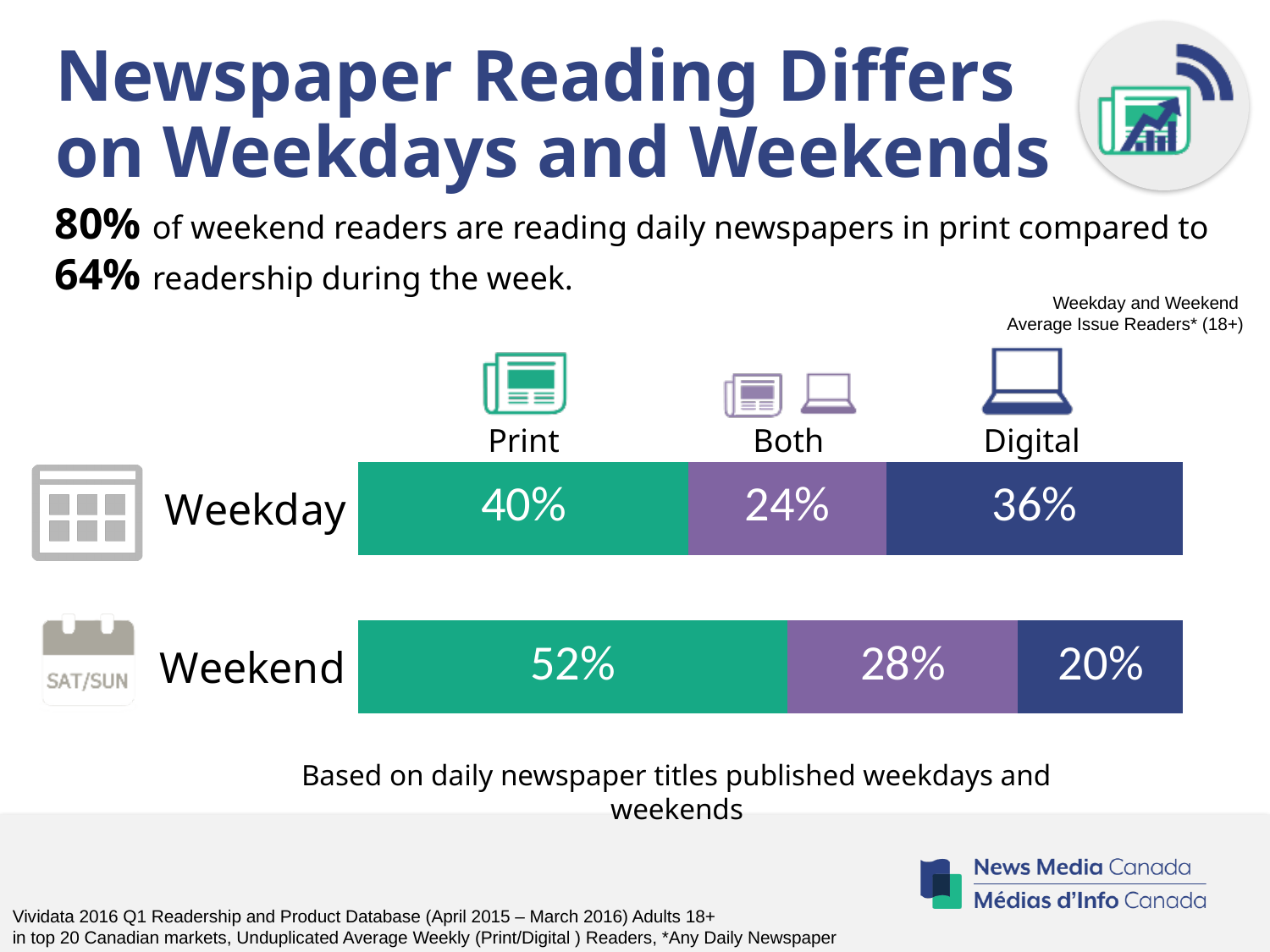
How many series does the chart legend list? 3 Which segment is the smallest for Weekday readers? Both What percentage of weekend readers read digital only? 20% Which segment is the largest for Weekend readers? Print Is the Digital share larger on Weekday or Weekend? Weekday What type of chart is shown on the slide? Stacked bar chart What percentage of weekday readers read in print only? 40% What is the difference between the Print share on Weekend and on Weekday? 12 percentage points How many categories (bars) does the chart show? 2 What percentage of weekend readers read both print and digital? 28% What is the total of the Weekday bar's segments? 100% What percentage of weekday readers read digital only? 36%